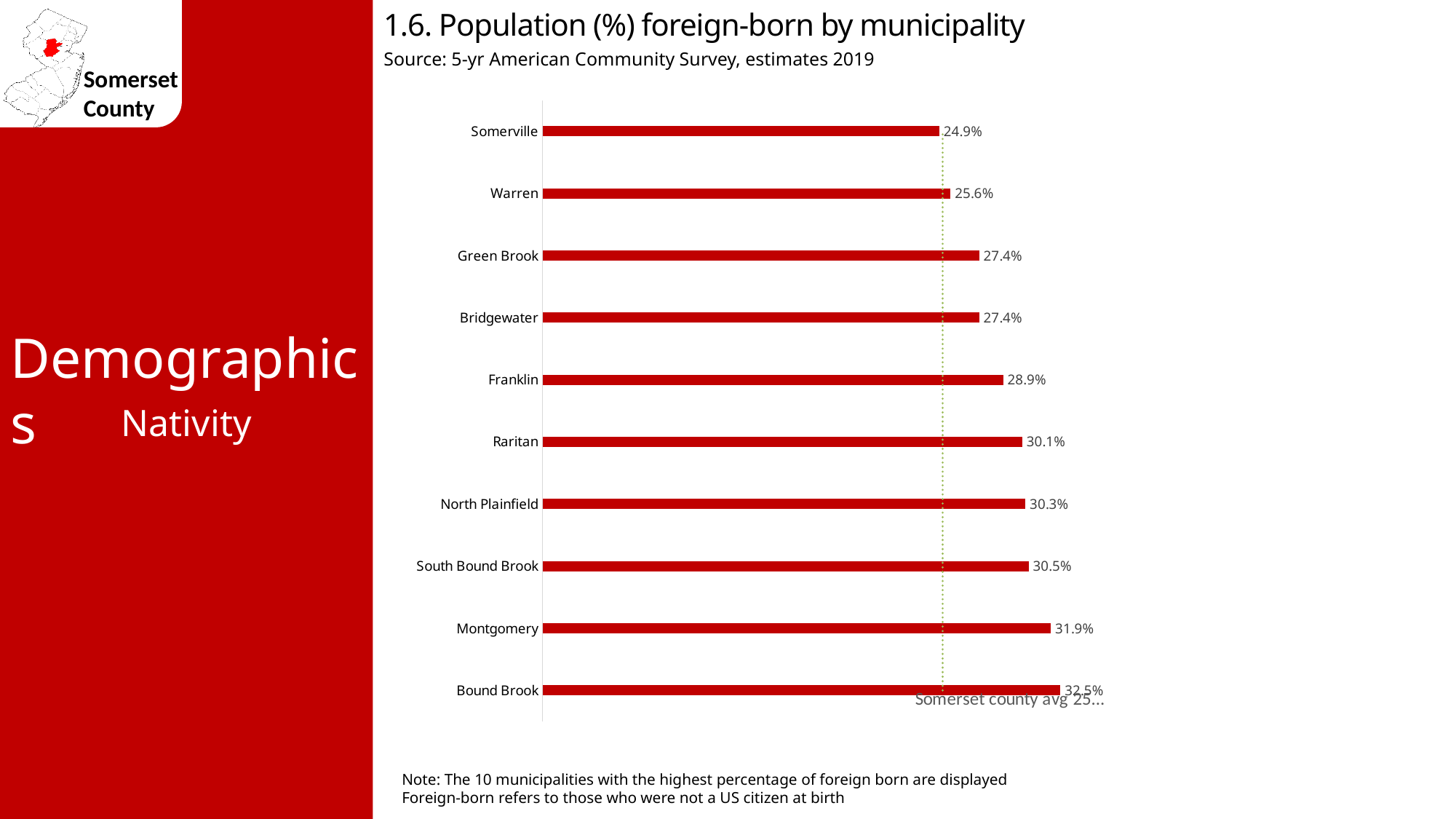
What is the percentage of foreign-born population in Franklin? 28.9% What is the percentage of foreign-born population in Bound Brook? 32.5% How many municipalities are shown in the chart? 10 Which has a higher foreign-born percentage, Raritan or Green Brook? Raritan Which municipality has the lowest percentage of foreign-born population? Somerville What is the difference in foreign-born percentage between Bound Brook and Somerville? 7.6 percentage points What is the difference in foreign-born percentage between Montgomery and Warren? 6.3 percentage points What type of chart is used to show the foreign-born population by municipality? Bar chart What is the percentage of foreign-born population in Somerville? 24.9% What is the title of the chart? 1.6. Population (%) foreign-born by municipality Which municipality has the highest percentage of foreign-born population? Bound Brook What is the percentage of foreign-born population in North Plainfield? 30.3%